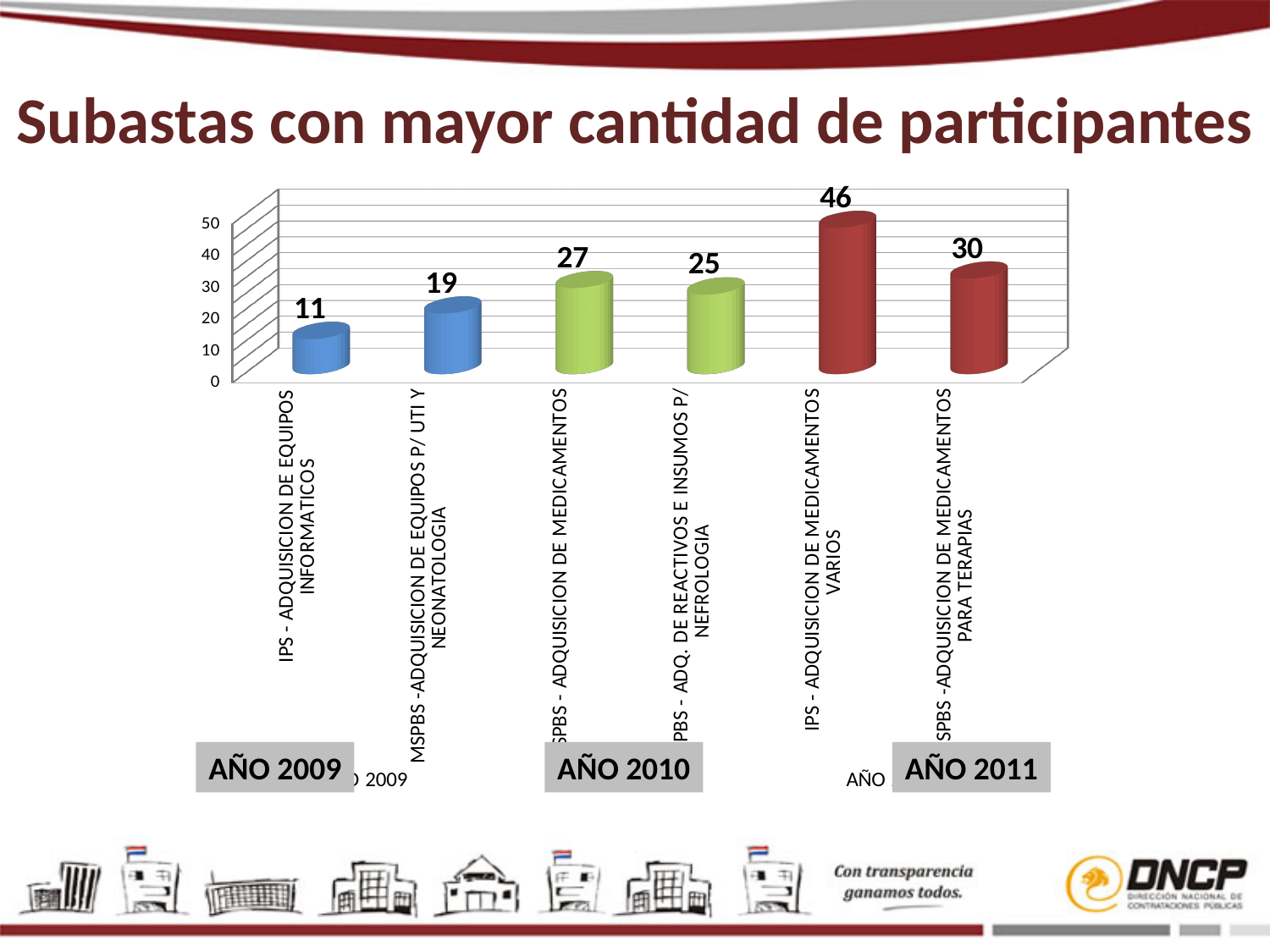
Which category has the highest value? IPS - ADQUISICION DE MEDICAMENTOS VARIOS What type of chart is shown on the slide? bar chart Which is larger: the value for ADQUISICION DE MEDICAMENTOS (27) or the value for ADQ. DE REACTIVOS E INSUMOS P/ NEFROLOGIA? ADQUISICION DE MEDICAMENTOS What is the difference between the value for IPS - ADQUISICION DE MEDICAMENTOS VARIOS and the value for IPS - ADQUISICION DE EQUIPOS INFORMATICOS? 35 Which year group do the red bars belong to? AÑO 2011 Which category has the lowest value? IPS - ADQUISICION DE EQUIPOS INFORMATICOS What is the value for IPS - ADQUISICION DE MEDICAMENTOS VARIOS? 46 What is the title of the slide? Subastas con mayor cantidad de participantes How many bars are plotted in the chart? 6 What is the value for MSPBS - ADQUISICION DE EQUIPOS P/ UTI Y NEONATOLOGIA? 19 What is the value for IPS - ADQUISICION DE EQUIPOS INFORMATICOS? 11 What is the value for the bar labelled ADQUISICION DE MEDICAMENTOS PARA TERAPIAS? 30